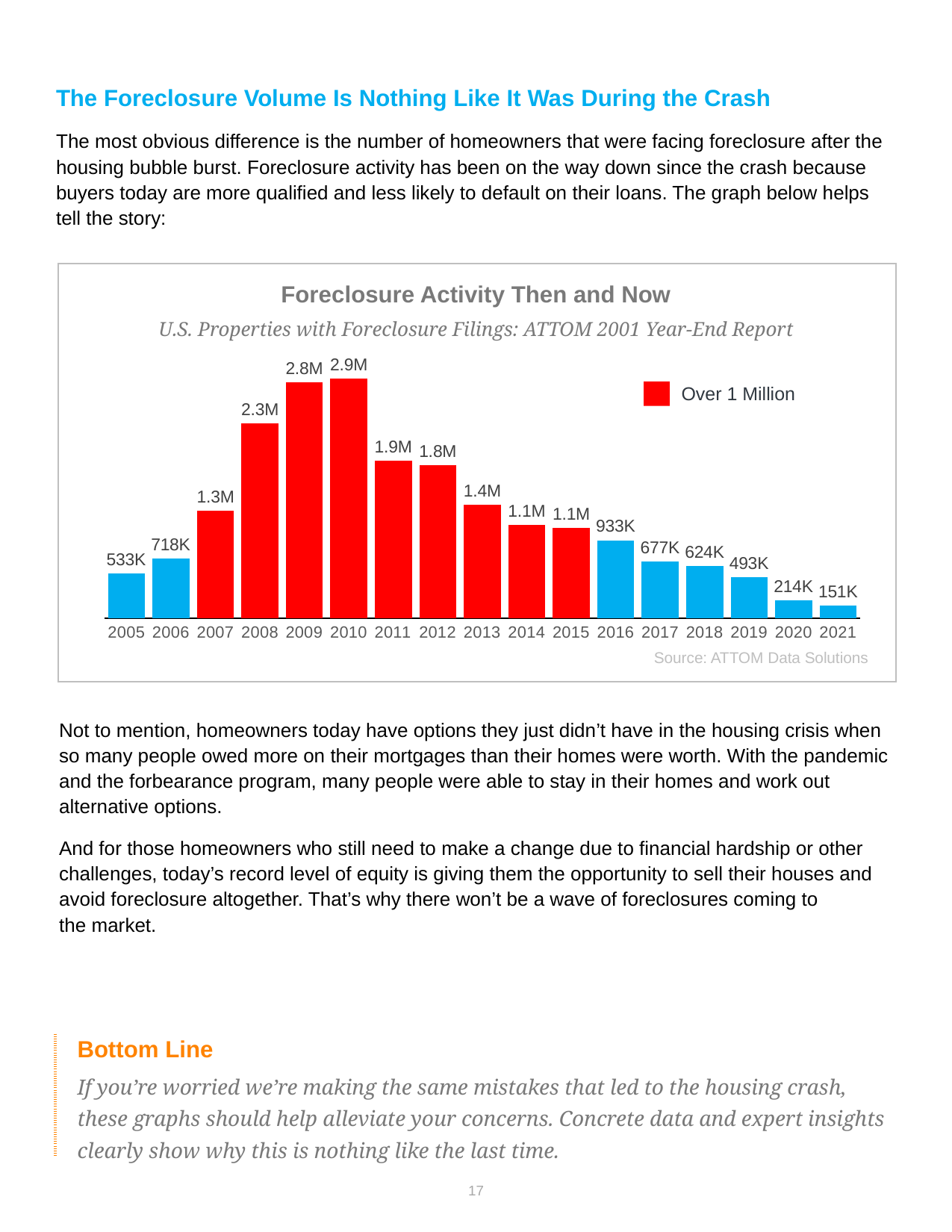
What is the value for 2021? 151K How many years are shown on the x axis? 17 What is the value for 2016? 933K What is the title of the chart? Foreclosure Activity Then and Now Do the values rise or fall from 2010 to 2021? fall What kind of chart is this? bar chart What does the red colour in the legend indicate? Over 1 Million What is the value for 2010? 2.9M Which year has the highest value? 2010 Which is larger, the value for 2005 or the value for 2006? 2006 What is the difference between the values for 2020 and 2021? 63K Which year has the lowest value? 2021